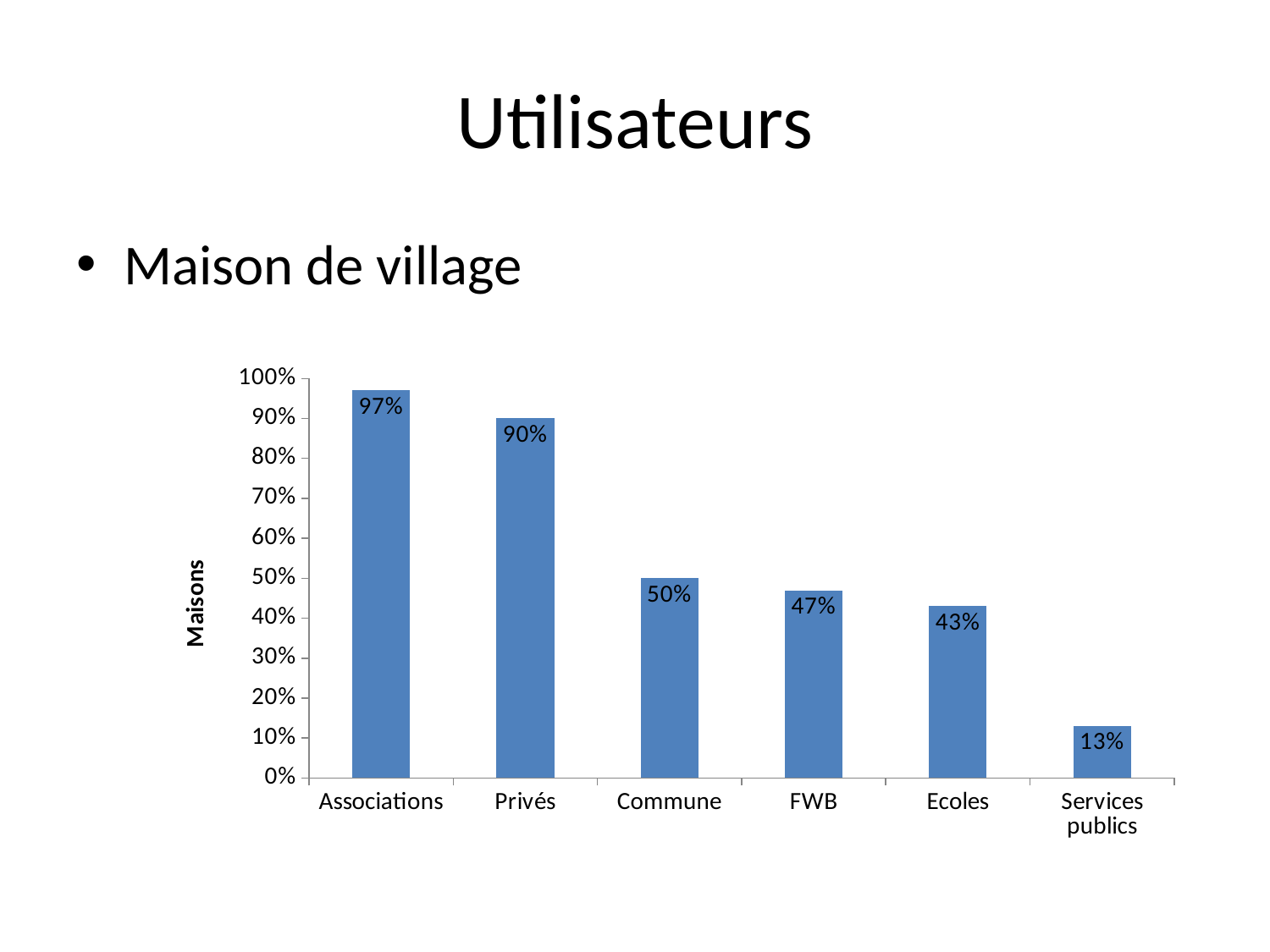
Which is larger, the value for Ecoles or the value for Commune? Commune What is the value for Associations? 97% Which category has the highest value? Associations What is the value for FWB? 47% How many categories are shown on the x axis? 6 Which category has the lowest value? Services publics What is the value for Privés? 90% What kind of chart is shown on the slide? Bar chart What is the difference between the values for Associations and Privés? 7% What is the value for Commune? 50% What is the value for Services publics? 13% What is the label of the vertical axis? Maisons